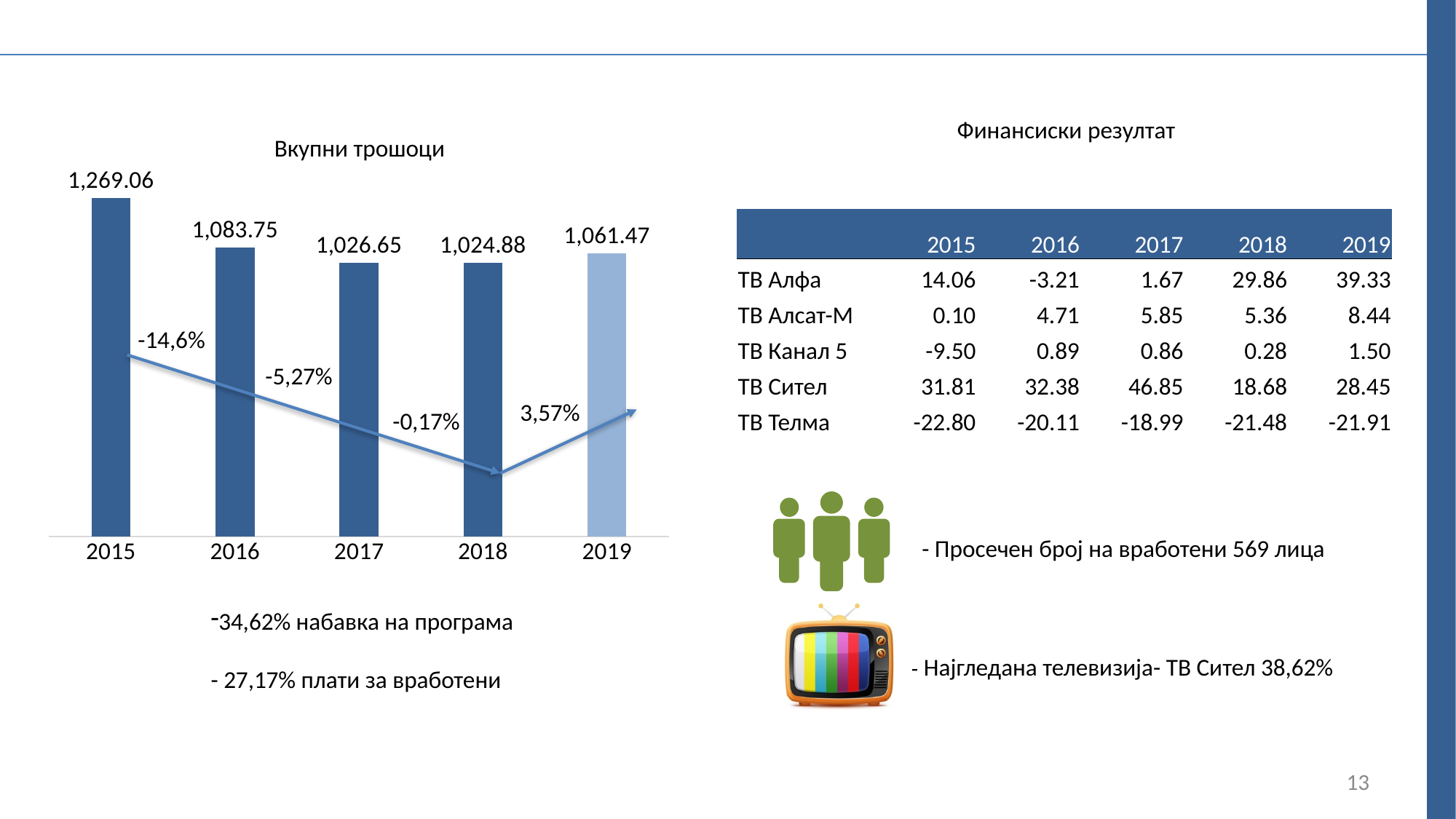
What type of chart is 'Вкупни трошоци'? Bar chart What percentage change is annotated between 2015 and 2016 in the 'Вкупни трошоци' chart? -14,6% In the 'Вкупни трошоци' chart, which is larger: the value for 2016 or the value for 2019? 2016 What is the difference between the 2015 and 2016 values in the 'Вкупни трошоци' chart? 185.31 What is the value of the bar for 2019 in the 'Вкупни трошоци' chart? 1,061.47 Which year has the highest value in the 'Вкупни трошоци' chart? 2015 How many bars are shown in the 'Вкупни трошоци' chart? 5 Do the values in the 'Вкупни трошоци' chart rise or fall from 2015 to 2018? Fall What is the value of the bar for 2017 in the 'Вкупни трошоци' chart? 1,026.65 What is the value of the bar for 2015 in the 'Вкупни трошоци' chart? 1,269.06 What is the difference between the 2019 and 2018 values in the 'Вкупни трошоци' chart? 36.59 Which year has the lowest value in the 'Вкупни трошоци' chart? 2018